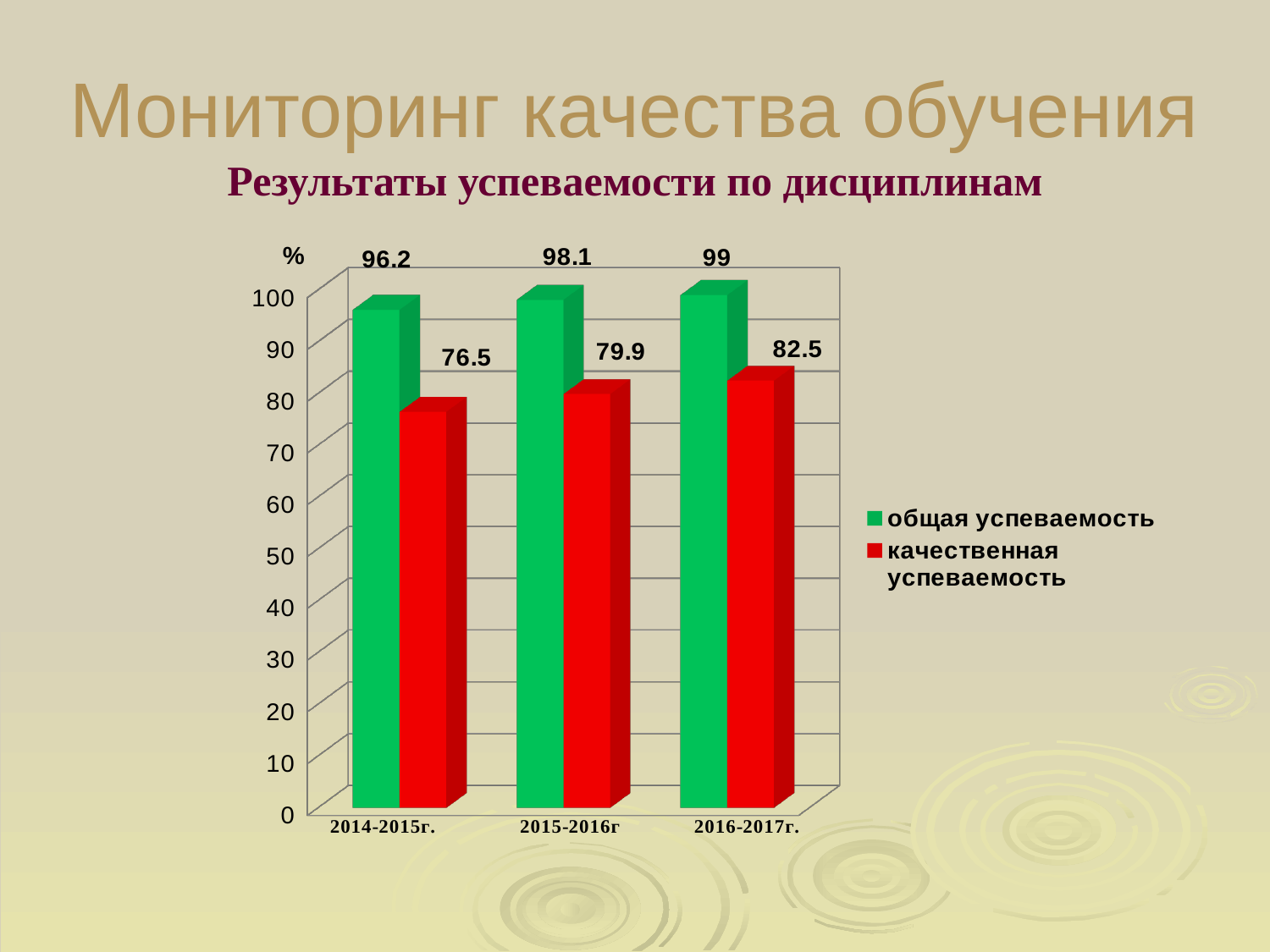
How many year categories are shown on the x axis? 3 How many series does the legend list? 2 What is the value of качественная успеваемость for 2015-2016г? 79.9 What is the value of качественная успеваемость for 2016-2017г.? 82.5 In which year is качественная успеваемость lowest? 2014-2015г. What is the value of общая успеваемость for 2014-2015г.? 96.2 By how much did качественная успеваемость increase from 2014-2015г. to 2016-2017г.? 6 In which year is общая успеваемость highest? 2016-2017г. Does качественная успеваемость rise or fall from 2014-2015г. to 2016-2017г.? rise Which is larger in 2015-2016г: общая успеваемость or качественная успеваемость? общая успеваемость What is the difference between общая успеваемость and качественная успеваемость in 2014-2015г.? 19.7 What kind of chart is shown on the slide? bar chart